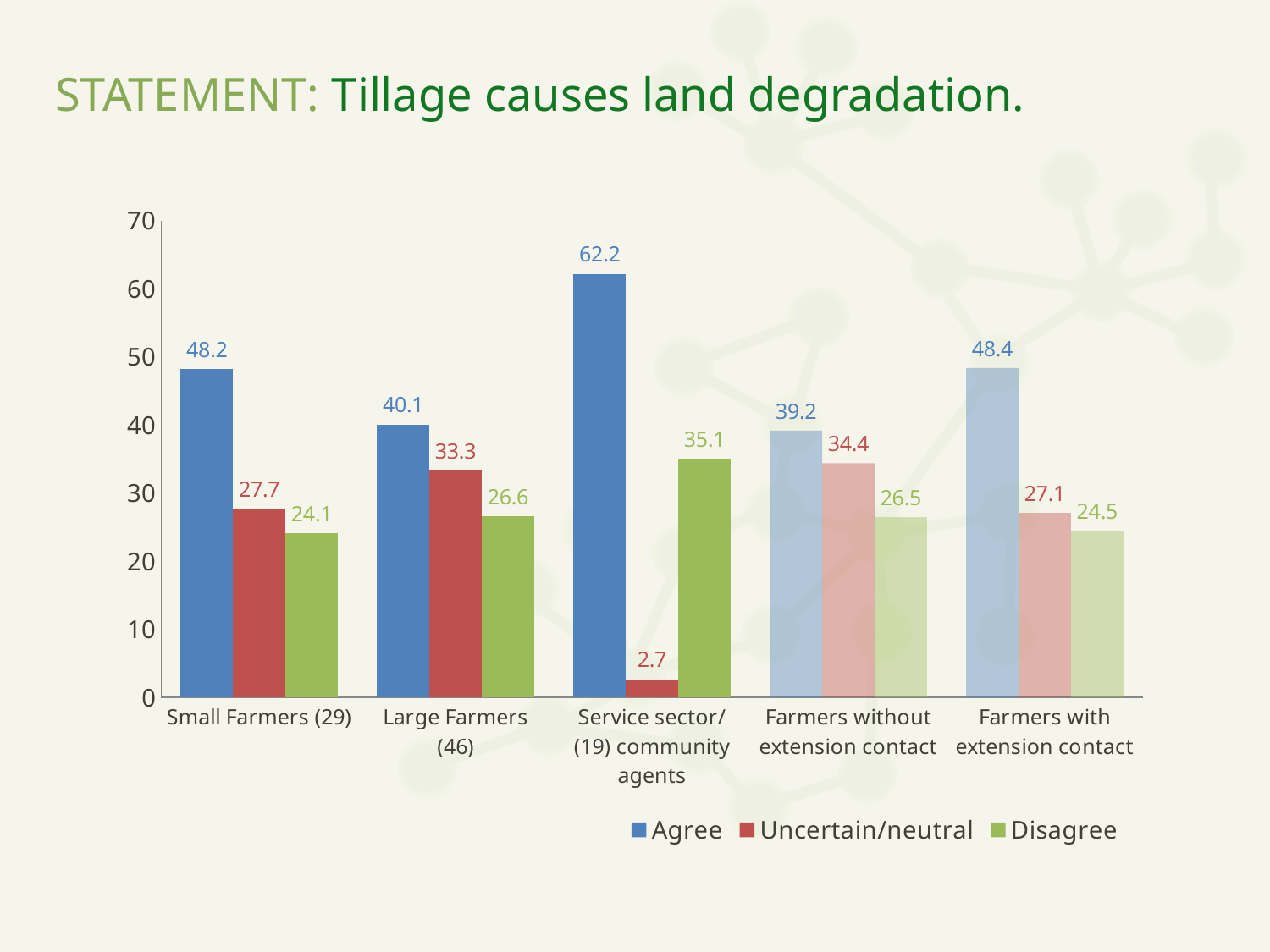
What statement is the chart about, according to the slide title? Tillage causes land degradation. What is the difference between the Agree and Disagree values for Small Farmers (29)? 24.1 Which category has the lowest Uncertain/neutral value? Service sector/(19) community agents Which category has the highest Disagree value? Service sector/(19) community agents What is the Uncertain/neutral value for Large Farmers (46)? 33.3 Which is larger for Farmers without extension contact: the Agree value or the Uncertain/neutral value? Agree What kind of chart is shown on the slide? Bar chart What is the Agree value for Service sector/(19) community agents? 62.2 Which category has the highest Agree value? Service sector/(19) community agents How many categories are shown on the x axis? 5 How many series does the legend list? 3 What is the Disagree value for Farmers with extension contact? 24.5